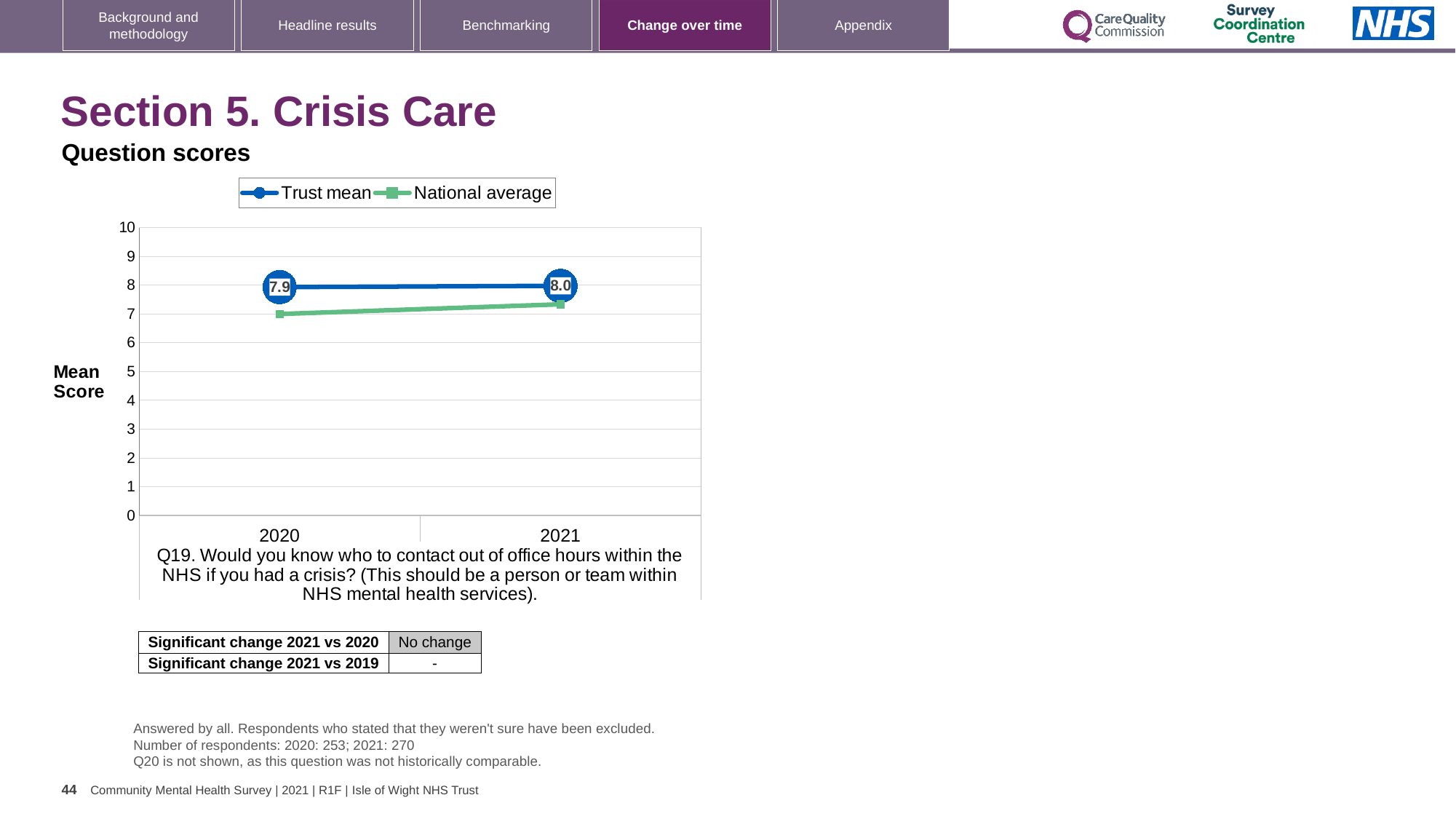
What is the Trust mean score for 2021? 8.0 Does the National average rise or fall from 2020 to 2021? rise In 2020, which is larger: the Trust mean or the National average? Trust mean By how much did the Trust mean change from 2020 to 2021? 0.1 How many series does the legend list? 2 Is the National average for 2021 greater or less than 6? greater Is the National average for 2020 greater or less than 8? less How many years are plotted on the x axis? 2 What kind of chart is shown on the slide? line chart What is the Trust mean score for 2020? 7.9 What is the label on the y axis of the chart? Mean Score In which year is the Trust mean higher, 2020 or 2021? 2021